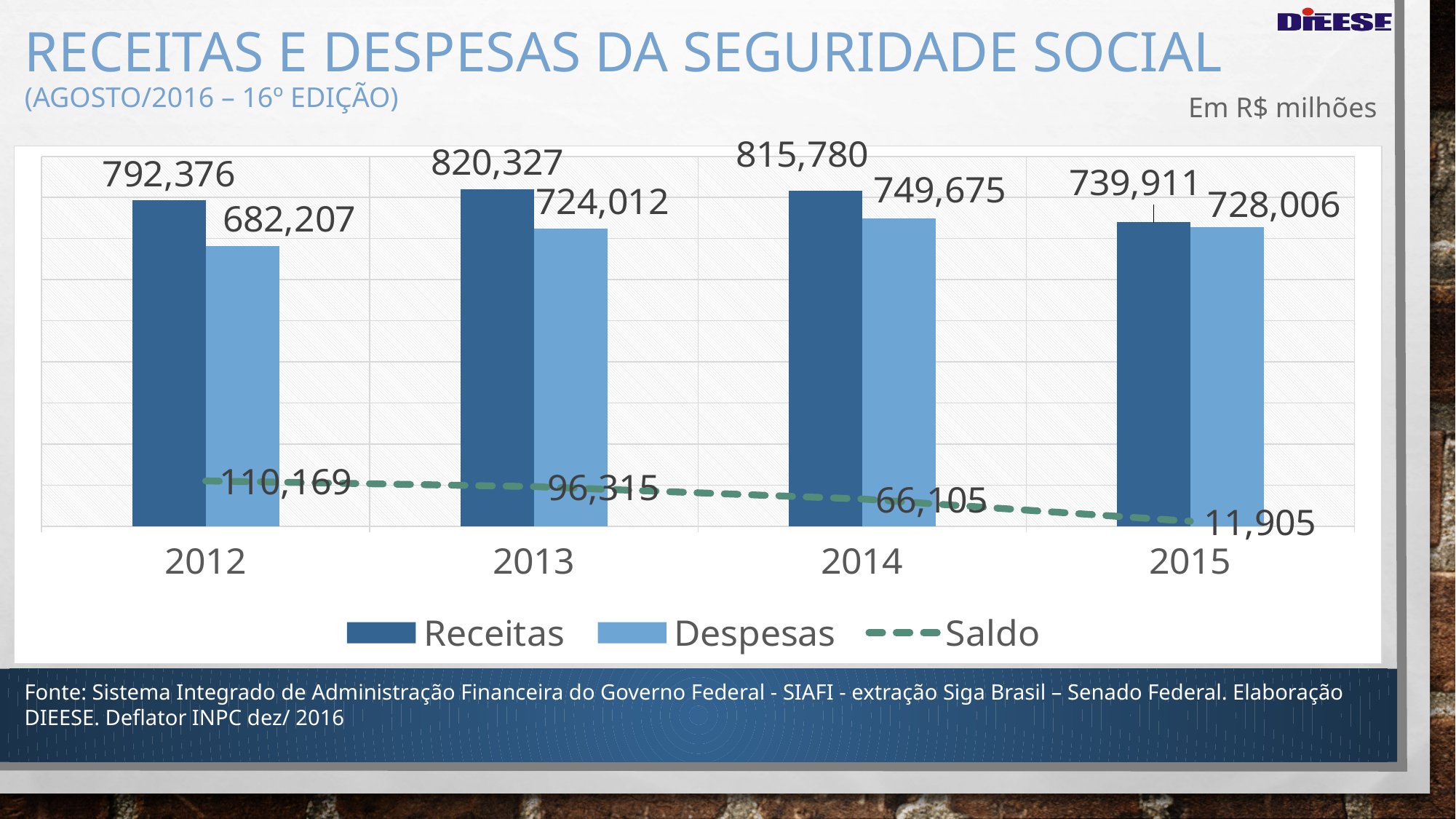
What is the difference between Despesas in 2014 and Despesas in 2013? 25,663 How many series does the legend list? 3 What is the difference between Receitas and Despesas in 2012? 110,169 What is the value of Receitas for 2013? 820,327 What unit is stated for the values in the chart? Em R$ milhões Does the Saldo line rise or fall from 2012 to 2015? fall How many years are shown on the x axis? 4 In which year is Saldo lowest? 2015 In which year is Receitas highest? 2013 What is the Saldo value for 2015? 11,905 Which is larger in 2015, Receitas or Despesas? Receitas What is the value of Despesas for 2014? 749,675